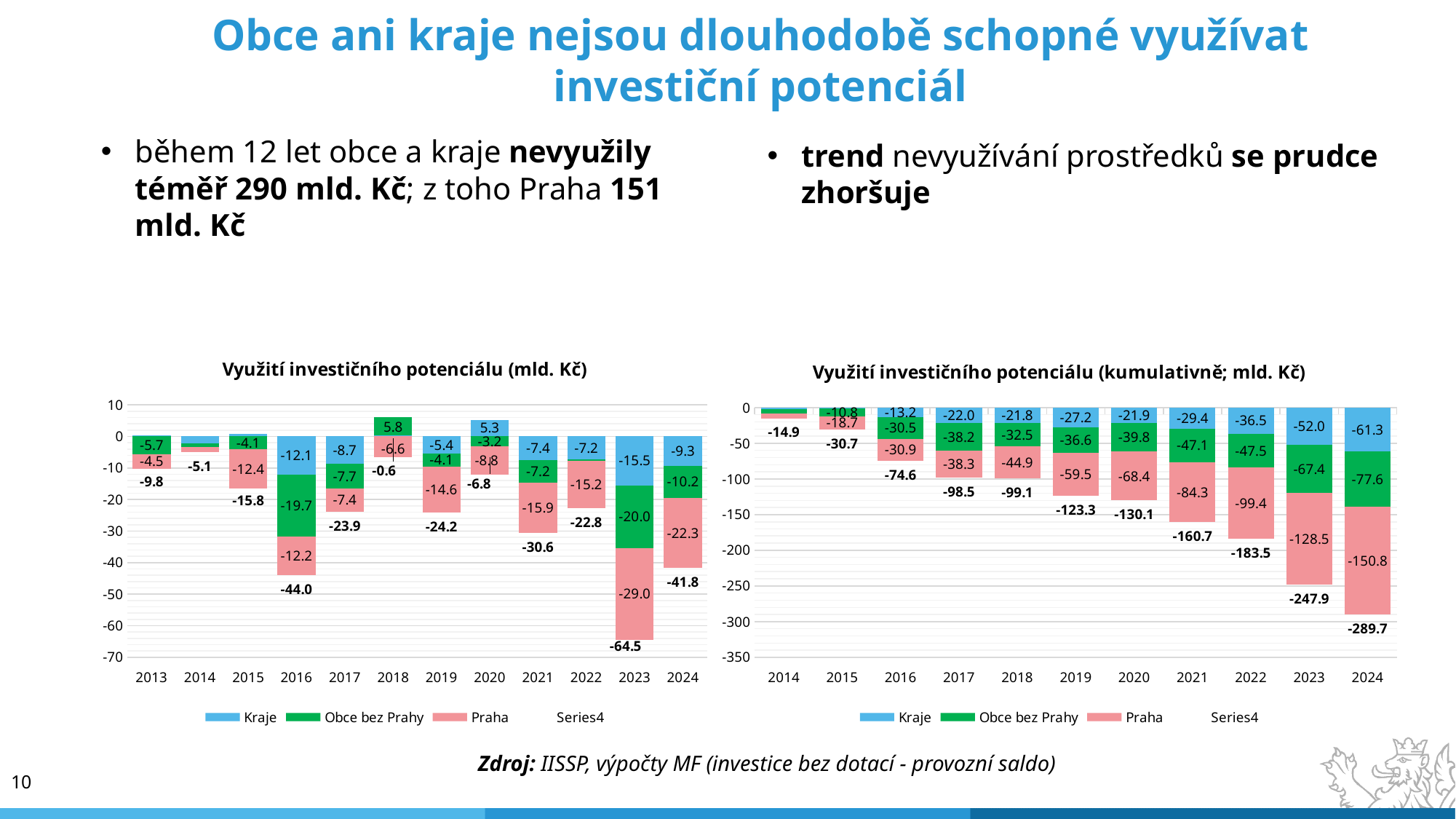
In the right chart 'Využití investičního potenciálu (kumulativně; mld. Kč)', do the cumulative totals rise or fall from 2014 to 2024? fall In the left chart 'Využití investičního potenciálu (mld. Kč)', what is the total value labelled for 2023? -64.5 In the right chart 'Využití investičního potenciálu (kumulativně; mld. Kč)', how many years are shown on the x axis? 11 How many series does the legend of the right chart 'Využití investičního potenciálu (kumulativně; mld. Kč)' list? 4 What kind of chart is the left chart 'Využití investičního potenciálu (mld. Kč)'? stacked bar chart In the right chart 'Využití investičního potenciálu (kumulativně; mld. Kč)', what is the total value labelled for 2024? -289.7 In the right chart 'Využití investičního potenciálu (kumulativně; mld. Kč)', what is the value of the Praha segment in 2022? -99.4 In the left chart 'Využití investičního potenciálu (mld. Kč)', how many years are shown on the x axis? 12 In the left chart 'Využití investičního potenciálu (mld. Kč)', which year has the lowest (most negative) total? 2023 In the left chart 'Využití investičního potenciálu (mld. Kč)', what is the value of the Kraje segment in 2020? 5.3 In the right chart 'Využití investičního potenciálu (kumulativně; mld. Kč)', what is the difference between the Praha segment in 2024 and the Praha segment in 2023? 22.3 In the left chart 'Využití investičního potenciálu (mld. Kč)', what is the value of the Praha segment in 2016? -12.2